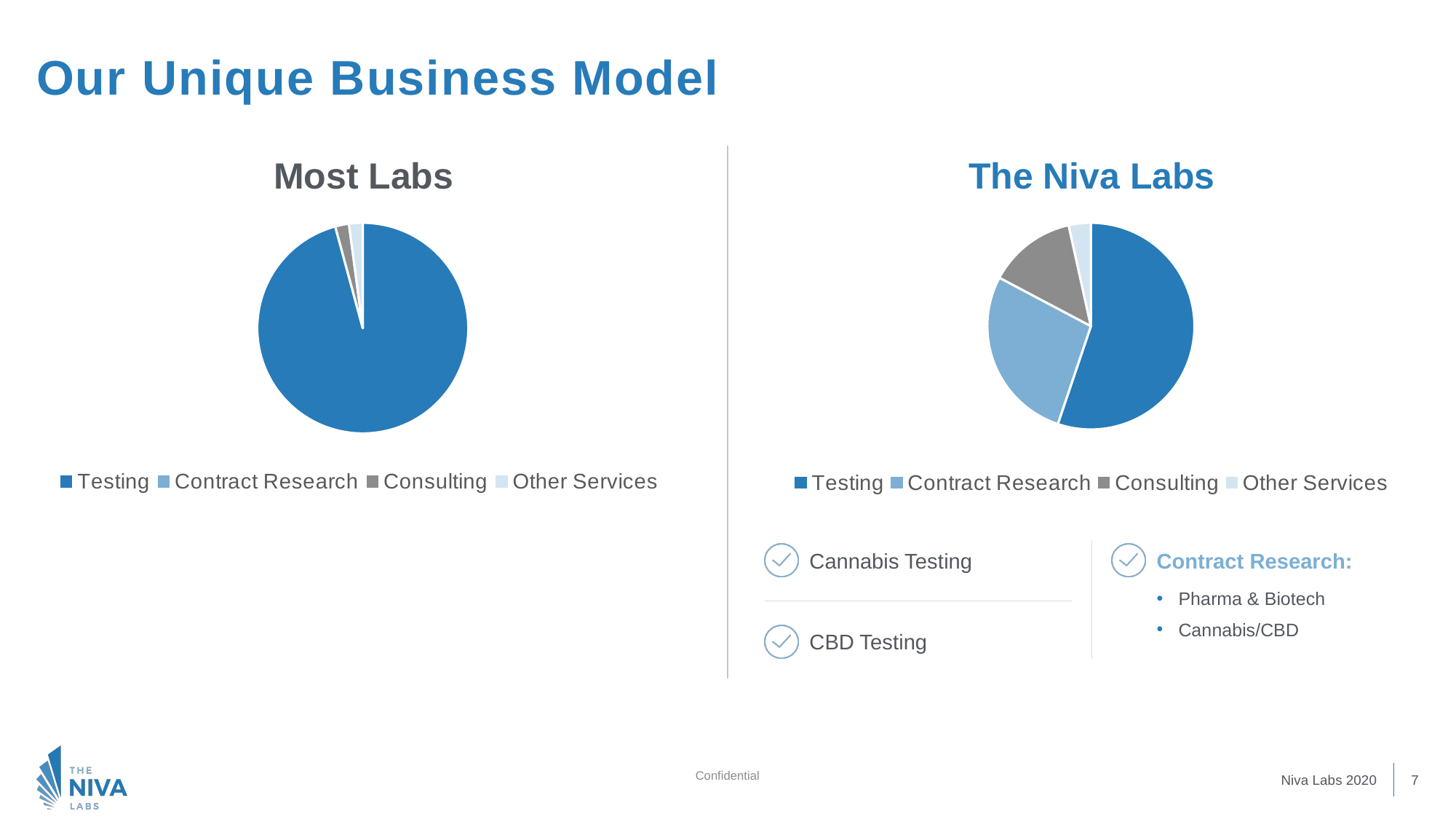
What kind of chart is the "Most Labs" chart? Pie chart In the "The Niva Labs" chart, which slice is larger: Testing or Contract Research? Testing How many pie charts are shown on the slide? 2 How many categories does the legend of the "The Niva Labs" chart list? 4 What are the legend entries of the "Most Labs" chart? Testing, Contract Research, Consulting, Other Services In the "The Niva Labs" chart, which category has the smallest slice? Other Services How many categories does the legend of the "Most Labs" chart list? 4 What kind of chart is the "The Niva Labs" chart? Pie chart Which chart shows a larger Contract Research slice: "Most Labs" or "The Niva Labs"? The Niva Labs In the "The Niva Labs" chart, which slice is larger: Contract Research or Consulting? Contract Research In the "Most Labs" chart, which category has the largest slice? Testing In the "The Niva Labs" chart, which category has the largest slice? Testing